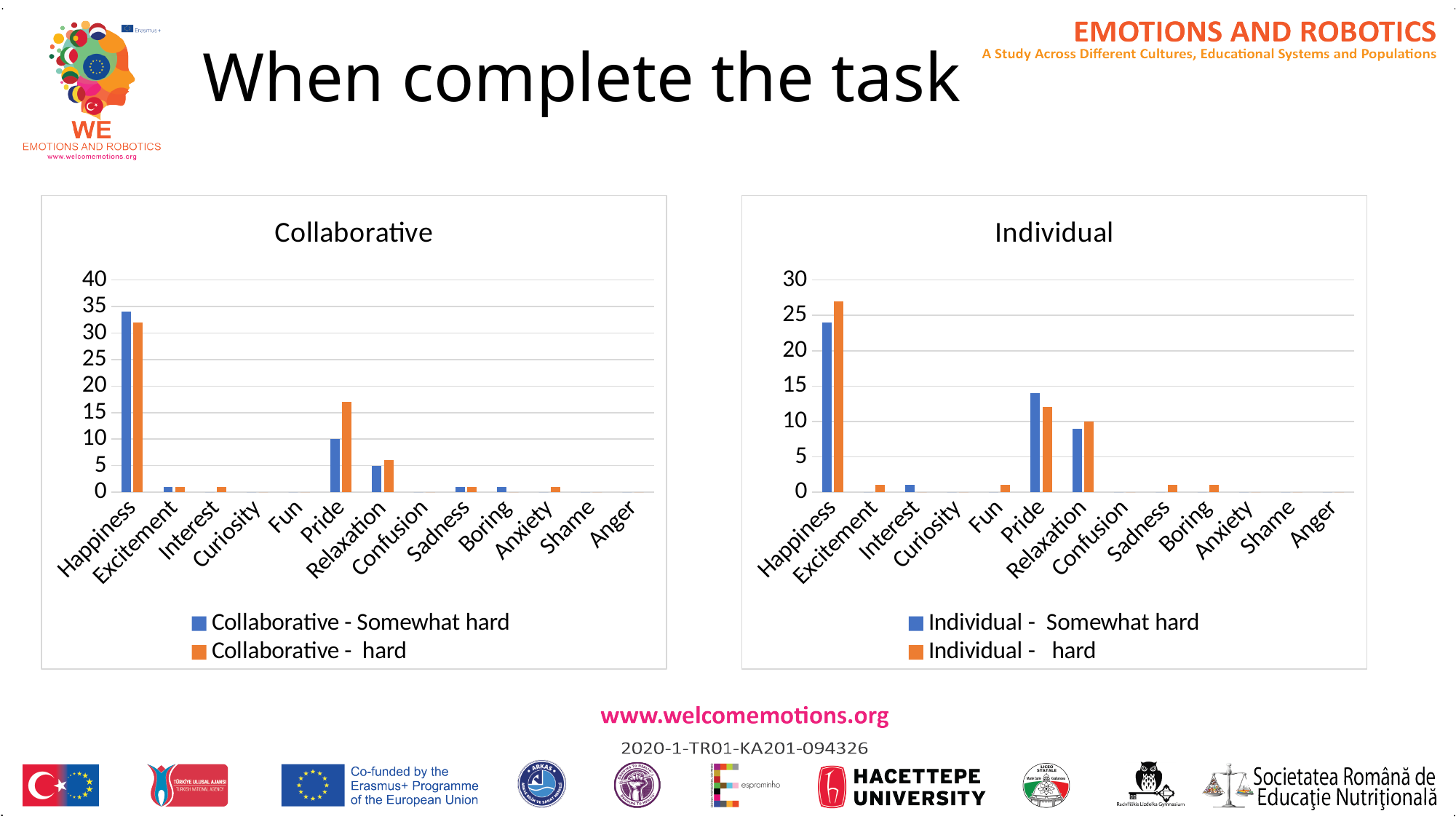
In the Collaborative chart, which emotion has the highest value for the 'Collaborative - Somewhat hard' series? Happiness In the Individual chart, which emotion has the highest value for the 'Individual - hard' series? Happiness In the Collaborative chart, which is larger for Pride: the 'Collaborative - Somewhat hard' value or the 'Collaborative - hard' value? Collaborative - hard What kind of chart is the Collaborative chart? bar chart In the Individual chart, which is larger for Happiness: the 'Individual - Somewhat hard' value or the 'Individual - hard' value? Individual - hard In the Individual chart, is the 'Individual - Somewhat hard' value for Pride greater or less than 10? greater In the Individual chart, is the 'Individual - hard' value for Happiness greater or less than 25? greater How many emotion categories are shown on the x axis of the Collaborative chart? 13 In the Collaborative chart, is the 'Collaborative - hard' value for Pride greater or less than 15? greater What colour represents the 'Individual - hard' series in the Individual chart? orange How many series does the legend of the Individual chart list? 2